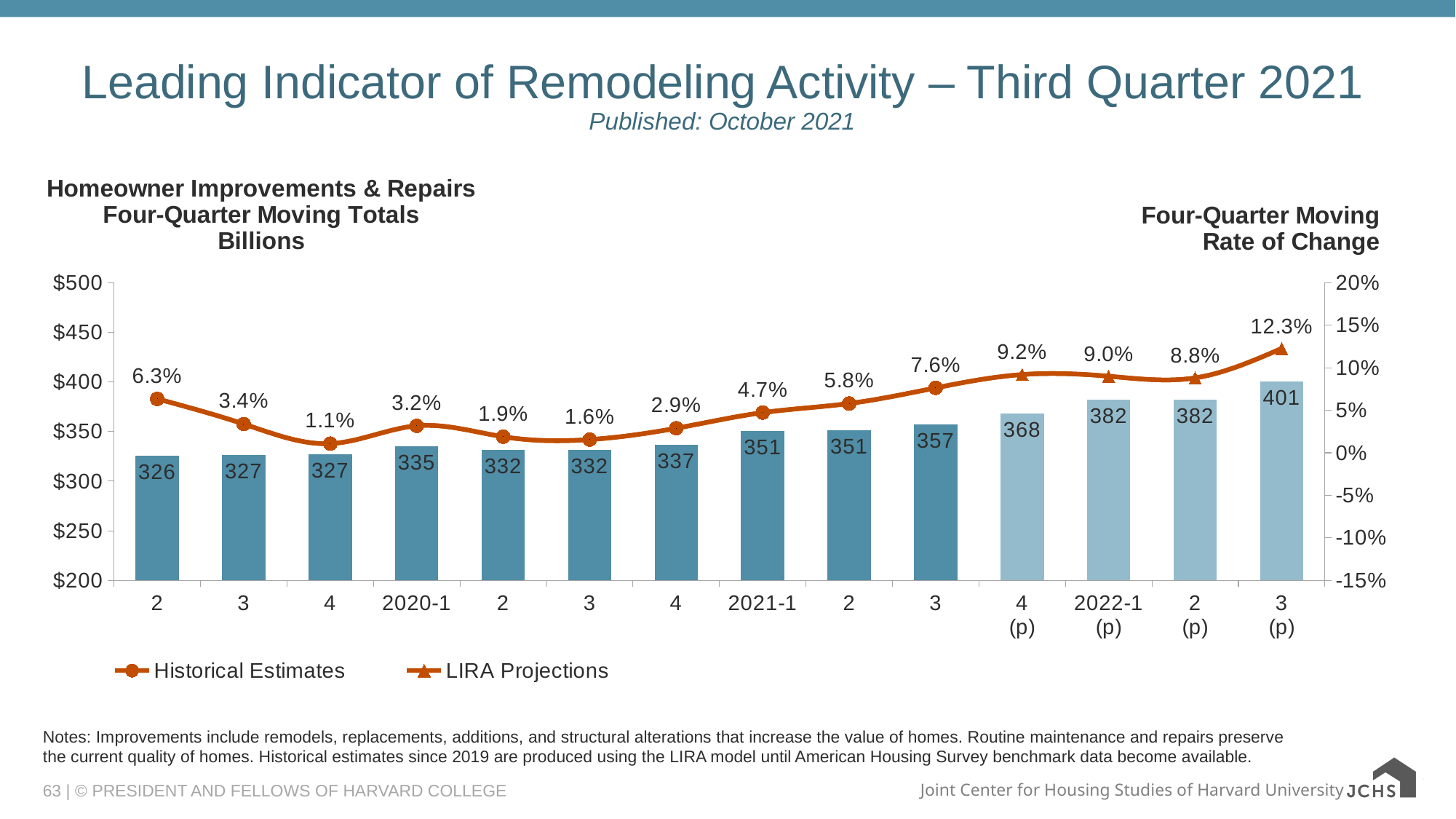
What four-quarter moving rate of change is labeled for 2020-1? 3.2% Which is larger, the bar value for 2021-1 or the bar value for 2020-1? 2021-1 What is the difference between the bar values for 3 (p) and 2022-1 (p)? 19 What rate of change is labeled for 2022-1 (p)? 9.0% Which quarter has the highest four-quarter moving rate of change on the line? 3 (p) Which quarter has the lowest four-quarter moving rate of change on the line? 4 (the quarter before 2020-1) What is the four-quarter moving total (in billions) shown on the bar for 2021-1? 351 Do the bar values generally rise or fall from left to right across the chart? rise What is the value of the bar for 3 (p), the last projected quarter? 401 How many quarters (bars) are plotted on the chart? 14 What are the two series named in the legend? Historical Estimates and LIRA Projections How many series does the legend list? 2